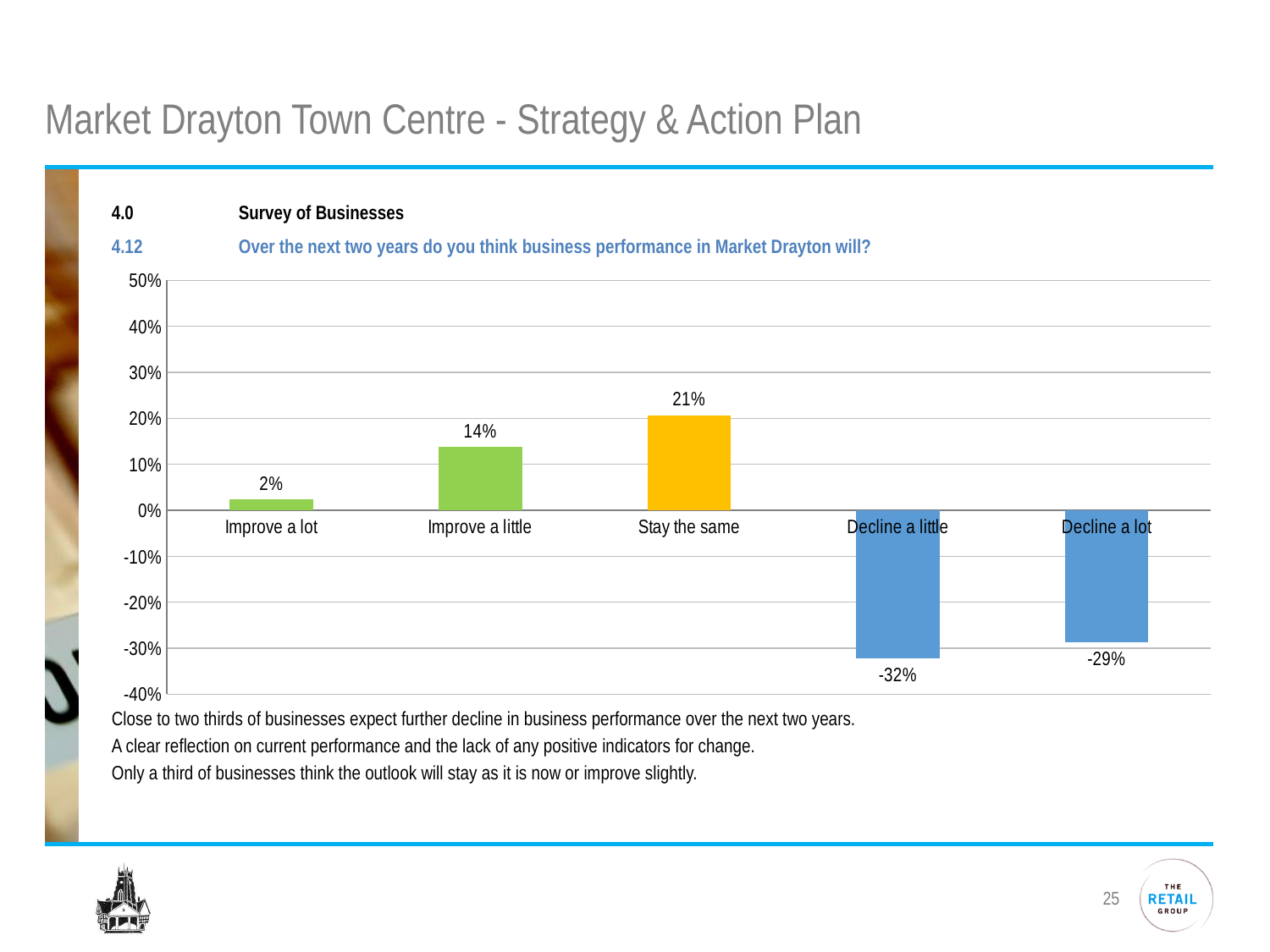
What kind of chart is shown on the slide? Bar chart Which category has the lowest value? Decline a little What is the value for 'Decline a little'? -32% How many categories are shown on the x axis? 5 Which is larger, the value for 'Improve a little' or the value for 'Improve a lot'? Improve a little Is the value for 'Decline a little' greater or less than -30%? less What colour are the bars for 'Decline a little' and 'Decline a lot'? Blue Which category has the highest value? Stay the same What is the value for 'Improve a lot'? 2% What is the value for 'Stay the same'? 21% What is the difference between the values for 'Stay the same' and 'Improve a little'? 7% What is the value for 'Decline a lot'? -29%